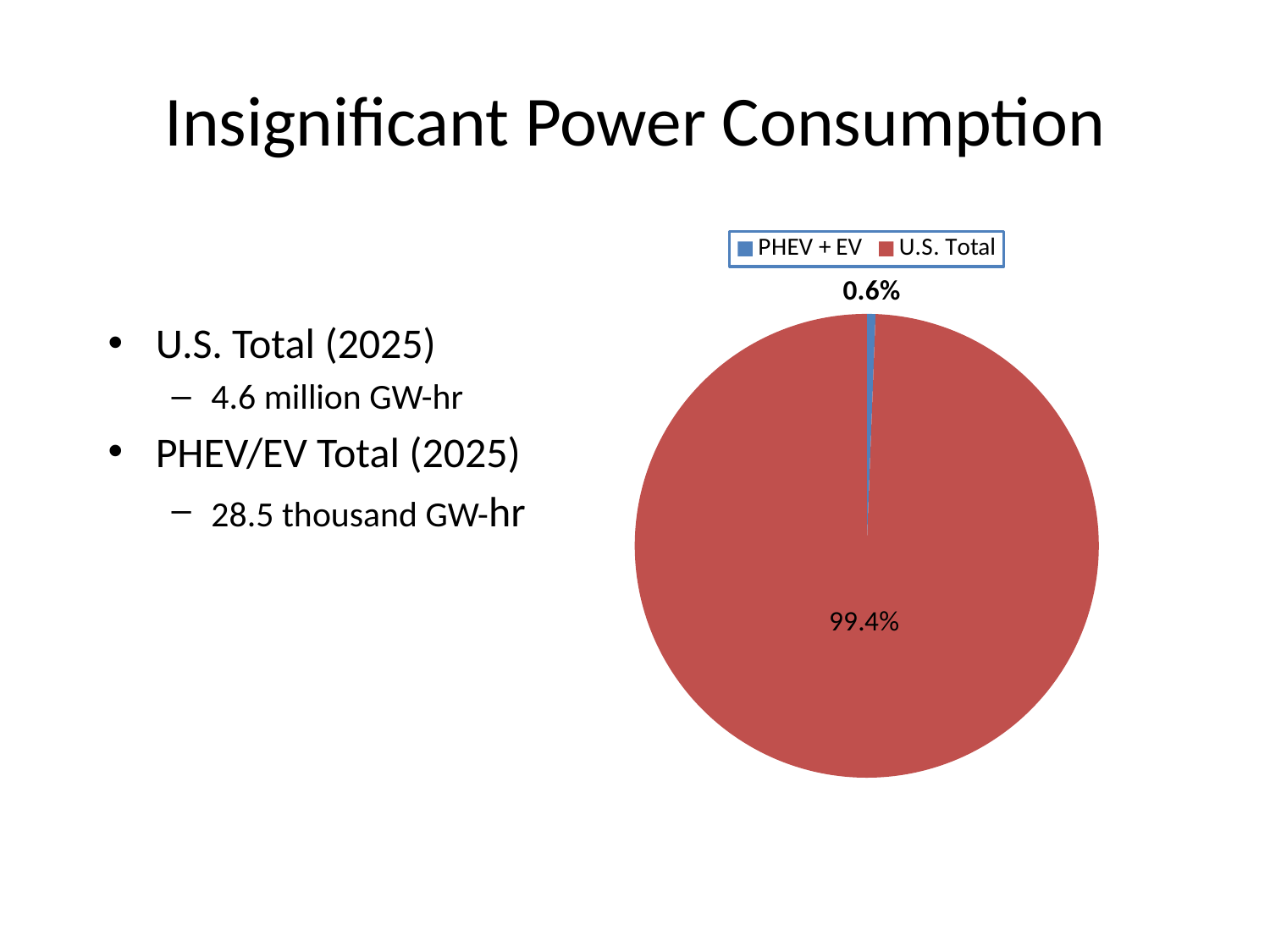
How many entries does the legend list? 2 Which is larger, the PHEV + EV slice or the U.S. Total slice? U.S. Total What share of the pie does the U.S. Total slice represent? 99.4% What share of the pie does the PHEV + EV slice represent? 0.6% How many slices does the pie chart have? 2 What colour is the PHEV + EV slice? blue What is the difference in percentage points between the U.S. Total slice and the PHEV + EV slice? 98.8 What kind of chart is shown on the slide? pie chart Which slice of the pie is the largest? U.S. Total Which slice of the pie is the smallest? PHEV + EV What colour is the U.S. Total slice? red